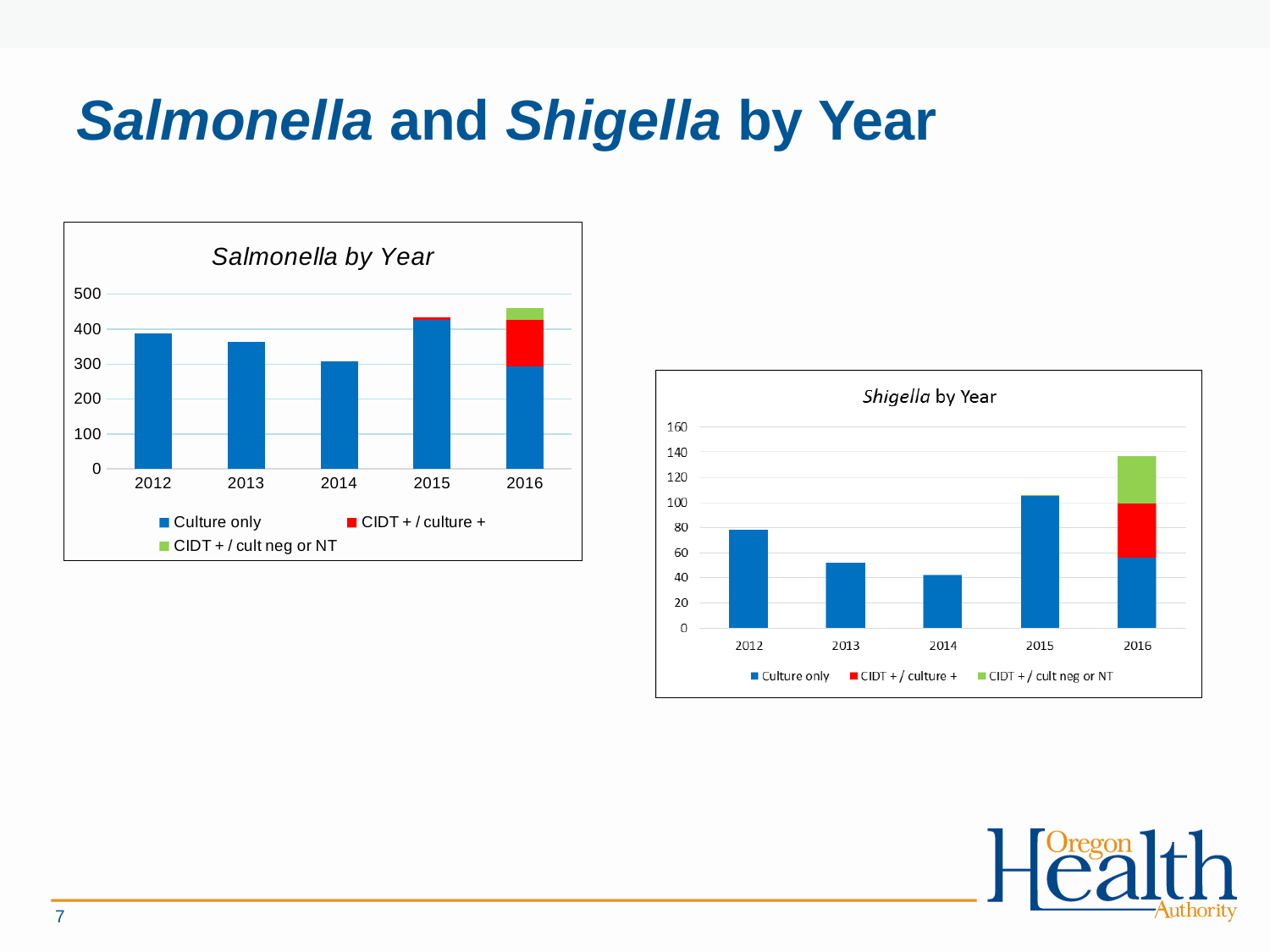
In the Salmonella by Year chart, is the value for 2012 greater or less than 300? greater How many years are shown on the x axis of the Shigella by Year chart? 5 In the Shigella by Year chart, is the value for 2015 greater or less than 80? greater Which legend entry in the Shigella by Year chart is shown in green? CIDT + / cult neg or NT How many series does the legend of the Salmonella by Year chart list? 3 In the Shigella by Year chart, is the value for 2014 greater or less than 60? less In the Shigella by Year chart, which year has the lowest total? 2014 What kind of chart is the Salmonella by Year chart? Bar chart In the Shigella by Year chart, which year has the larger bar, 2012 or 2013? 2012 In the Salmonella by Year chart, which year has the lowest total? 2014 In the Shigella by Year chart, which year has the highest total bar? 2016